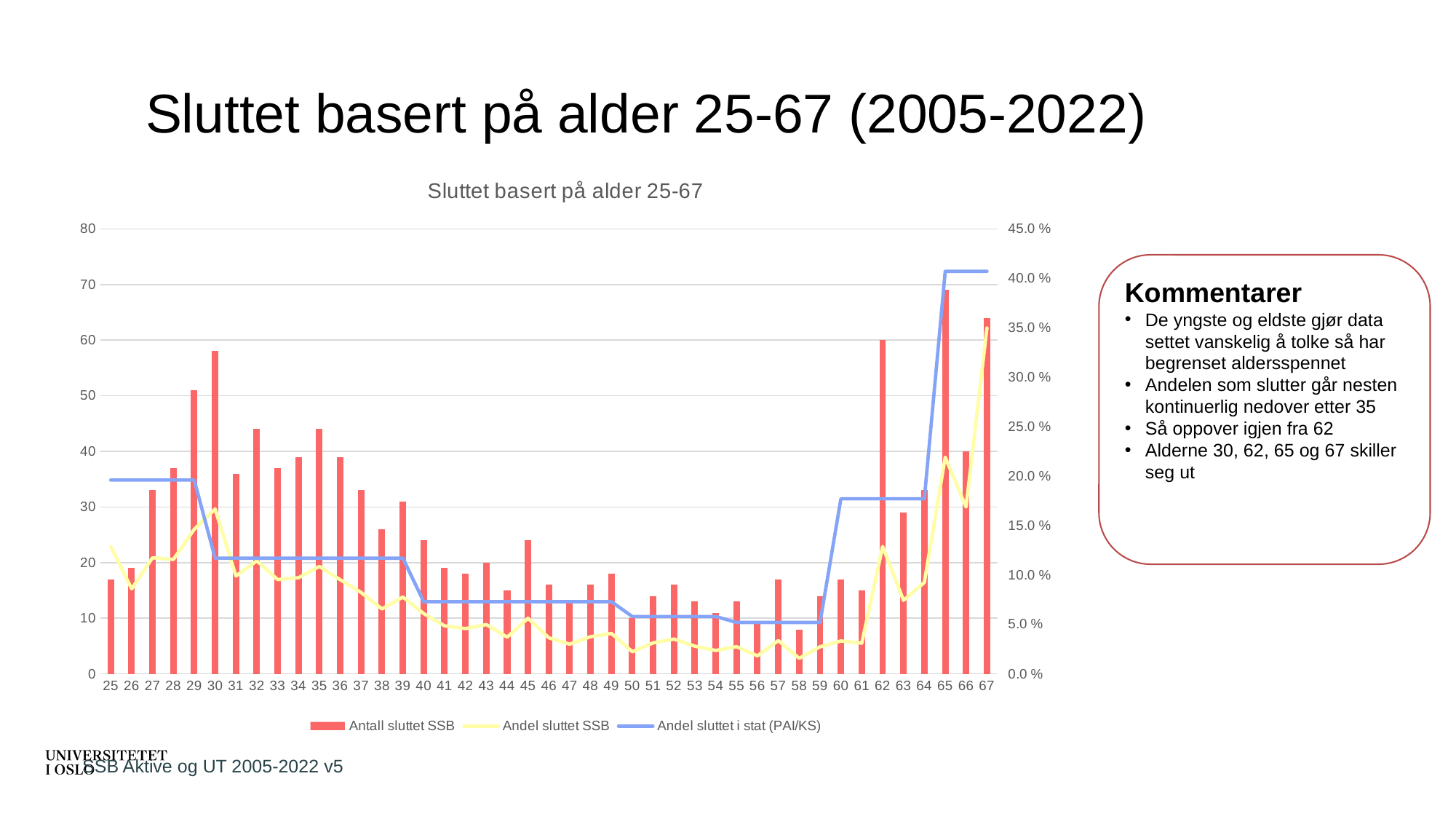
Which age has the lowest value for Antall sluttet SSB? 58 Which age has the larger Antall sluttet SSB value, 30 or 35? 30 What type of chart is shown on the slide? Combined bar and line chart Is the Antall sluttet SSB value for age 58 greater or less than 10? less Which age has the highest value for Antall sluttet SSB? 65 What is the title of the chart? Sluttet basert på alder 25-67 Does the Andel sluttet SSB line generally rise or fall between ages 35 and 58? fall Is the Antall sluttet SSB value for age 62 greater or less than 50? greater How many series does the legend list? 3 Which series is drawn as a blue line? Andel sluttet i stat (PAI/KS) How many age categories are shown on the x axis? 43 Is the Andel sluttet i stat (PAI/KS) value for age 66 greater or less than 35.0 %? greater